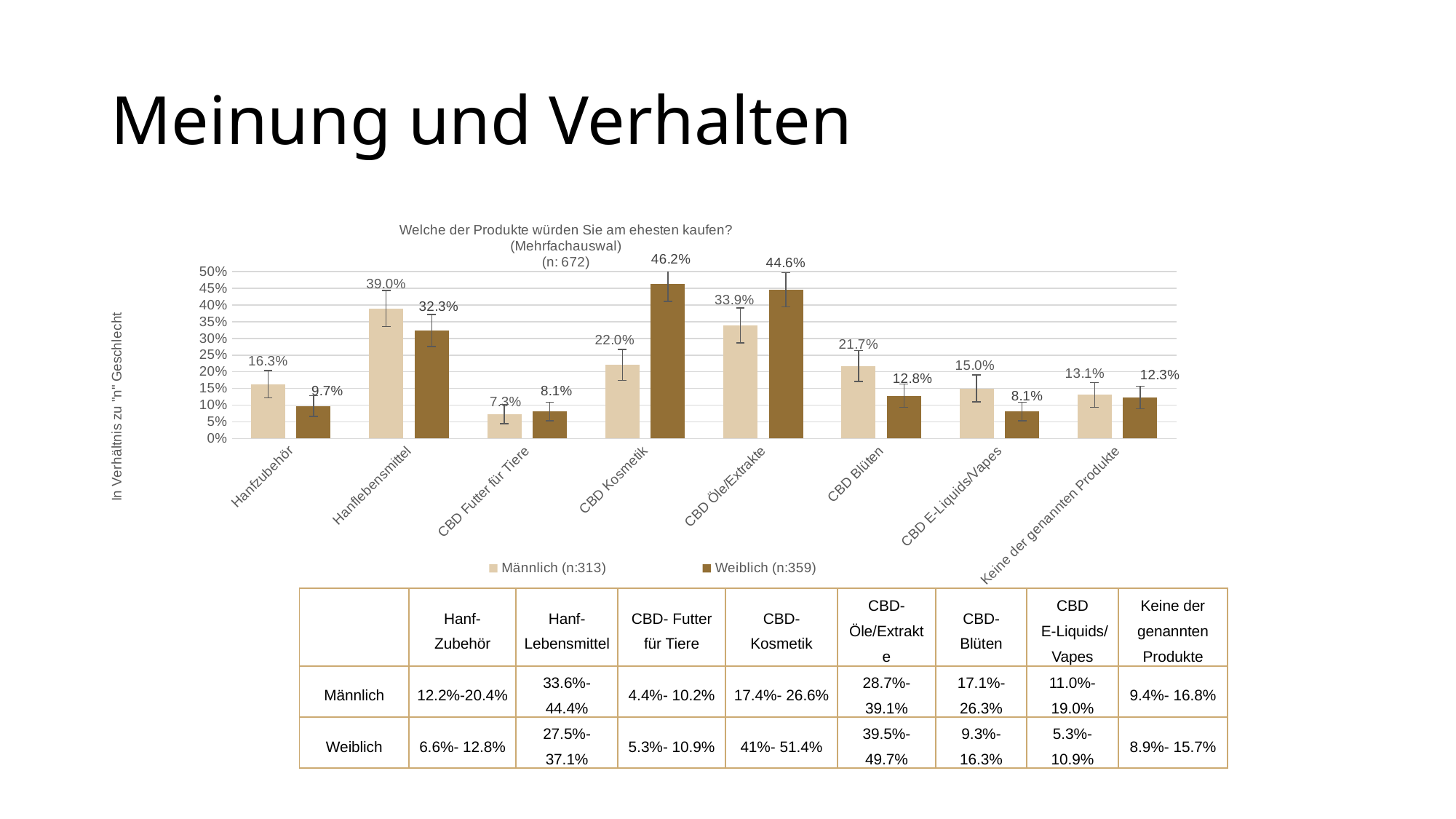
How many series does the chart legend list? 2 What kind of chart is shown on the slide? Bar chart Which category has the lowest value for Weiblich (n:359)? CBD Futter für Tiere and CBD E-Liquids/Vapes (both 8.1%) What is the value for Weiblich (n:359) for CBD E-Liquids/Vapes? 8.1% Which category has the highest value for Männlich (n:313)? Hanflebensmittel What is the difference between the Weiblich (n:359) and Männlich (n:313) values for CBD Kosmetik? 24.2% Is the value for Weiblich (n:359) for CBD Öle/Extrakte greater or less than 40%? greater For Hanfzubehör, which series has the larger value, Männlich (n:313) or Weiblich (n:359)? Männlich (n:313) What is the sample size (n) given in the chart title? 672 How many product categories are shown on the x axis of the chart? 8 What is the value for Weiblich (n:359) for CBD Kosmetik? 46.2% What is the value for Männlich (n:313) for Hanflebensmittel? 39.0%